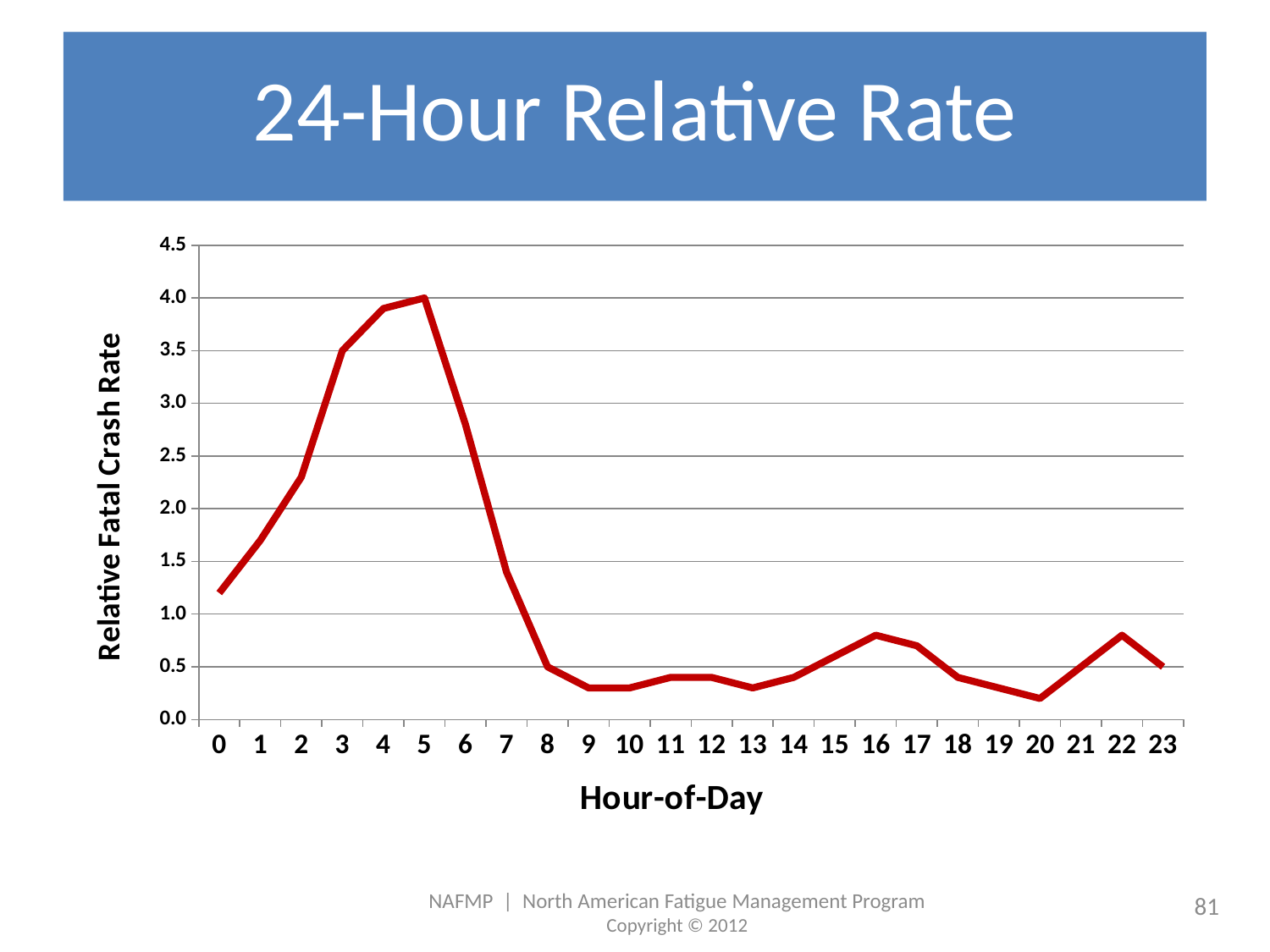
What kind of chart is shown on the slide? line chart What is the relative fatal crash rate at hour 5? 4.0 What is the relative fatal crash rate at hour 8? 0.5 Does the relative fatal crash rate rise or fall between hour 5 and hour 8? fall Is the relative fatal crash rate at hour 20 greater or less than 0.5? less At which hour of day is the relative fatal crash rate highest? 5 Which hour has a higher relative fatal crash rate, hour 4 or hour 16? hour 4 At which hour of day is the relative fatal crash rate lowest? 20 Is the relative fatal crash rate at hour 4 greater or less than 3.5? greater Is the relative fatal crash rate at hour 2 greater or less than 2.0? greater How many hour-of-day points are plotted on the chart? 24